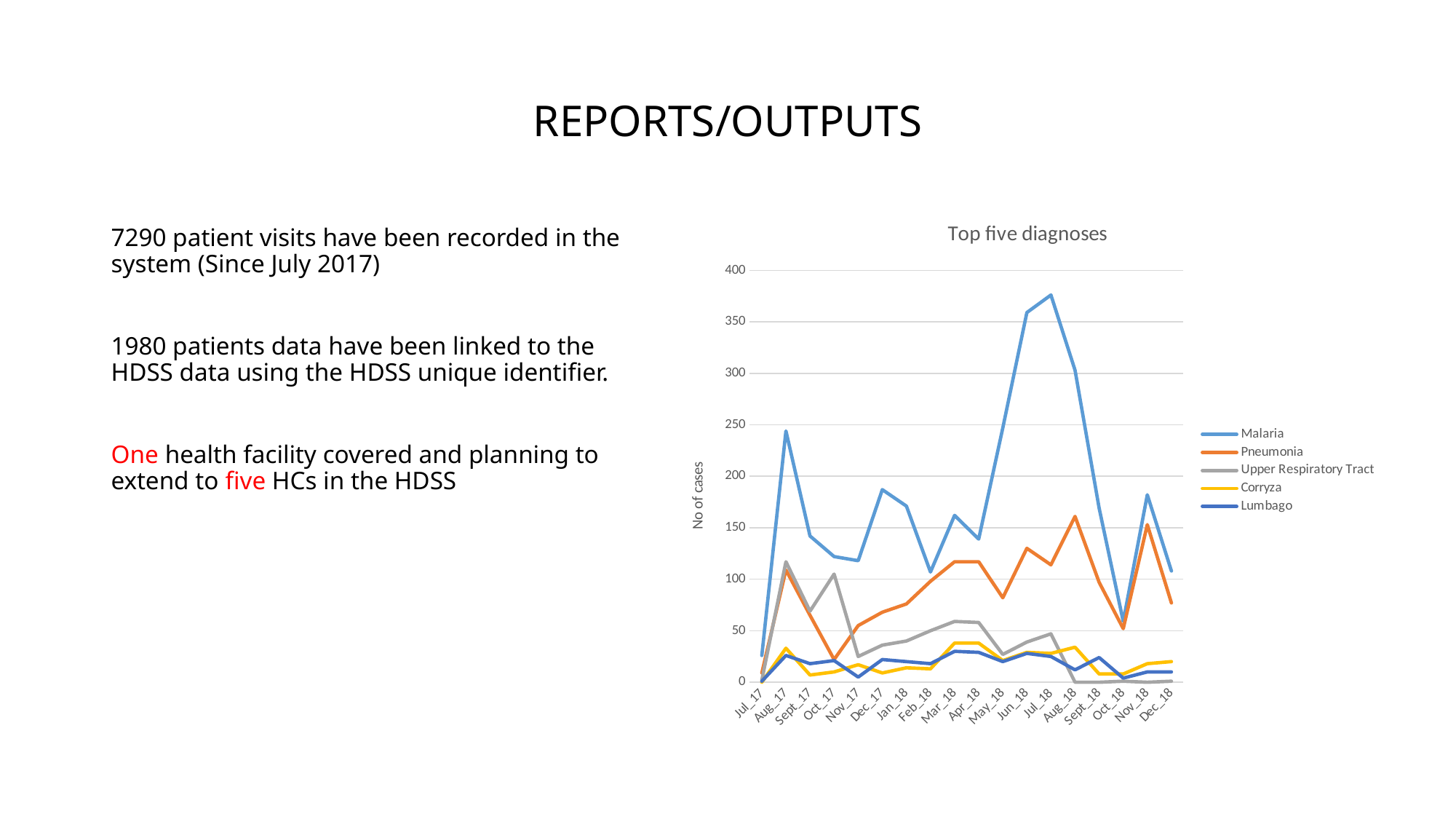
Is the Malaria value for Aug_17 greater or less than 200? greater What type of chart is shown on the slide? line chart How many series does the legend of the 'Top five diagnoses' chart list? 5 Which series reaches the highest value anywhere on the chart? Malaria In Jul_18, which is larger: Malaria or Pneumonia? Malaria How many months are shown on the x axis of the 'Top five diagnoses' chart? 18 Is the Malaria value for Jul_18 greater or less than 350? greater Does the Malaria line rise or fall from Jul_18 to Oct_18? fall What is the title of the chart? Top five diagnoses In which month does the Malaria line reach its highest value? Jul_18 Is the Pneumonia value for Oct_18 greater or less than 100? less What is the label on the y axis of the chart? No of cases